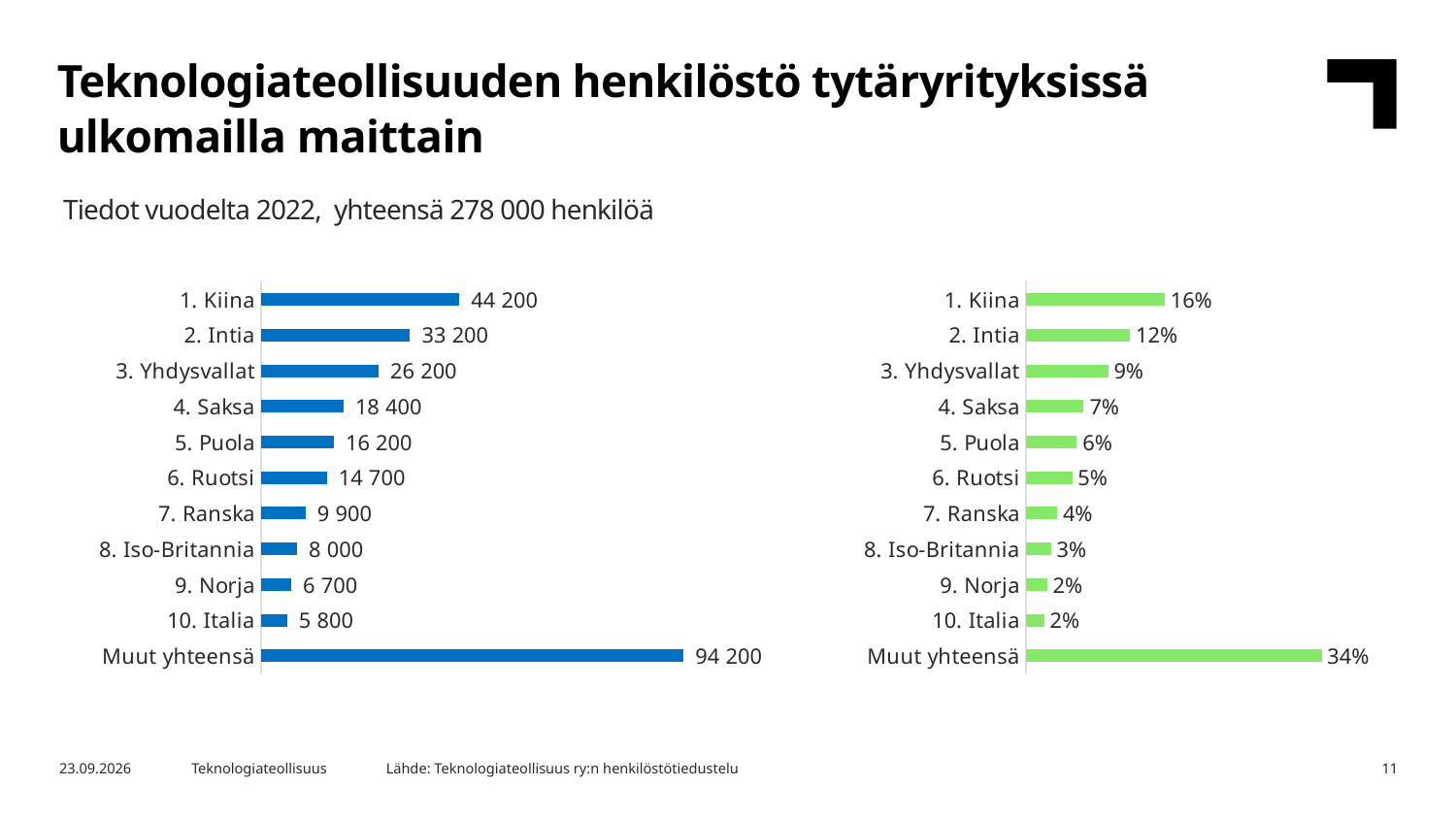
In the left chart, what is the value for Muut yhteensä? 94 200 In the right chart, what is the difference between the values for 1. Kiina and 4. Saksa? 9% In the right chart, what is the value for 8. Iso-Britannia? 3% In the left chart, what is the value for 1. Kiina? 44 200 In the right chart, what is the value for 3. Yhdysvallat? 9% In the left chart, which is larger, the value for 5. Puola or the value for 6. Ruotsi? 5. Puola In the right chart, which category has the highest value? Muut yhteensä In the left chart, what is the difference between the values for 2. Intia and 3. Yhdysvallat? 7 000 What colour are the bars in the left chart? blue In the left chart, which category has the lowest value? 10. Italia How many categories are shown in the left chart? 11 What kind of chart is the right chart? bar chart